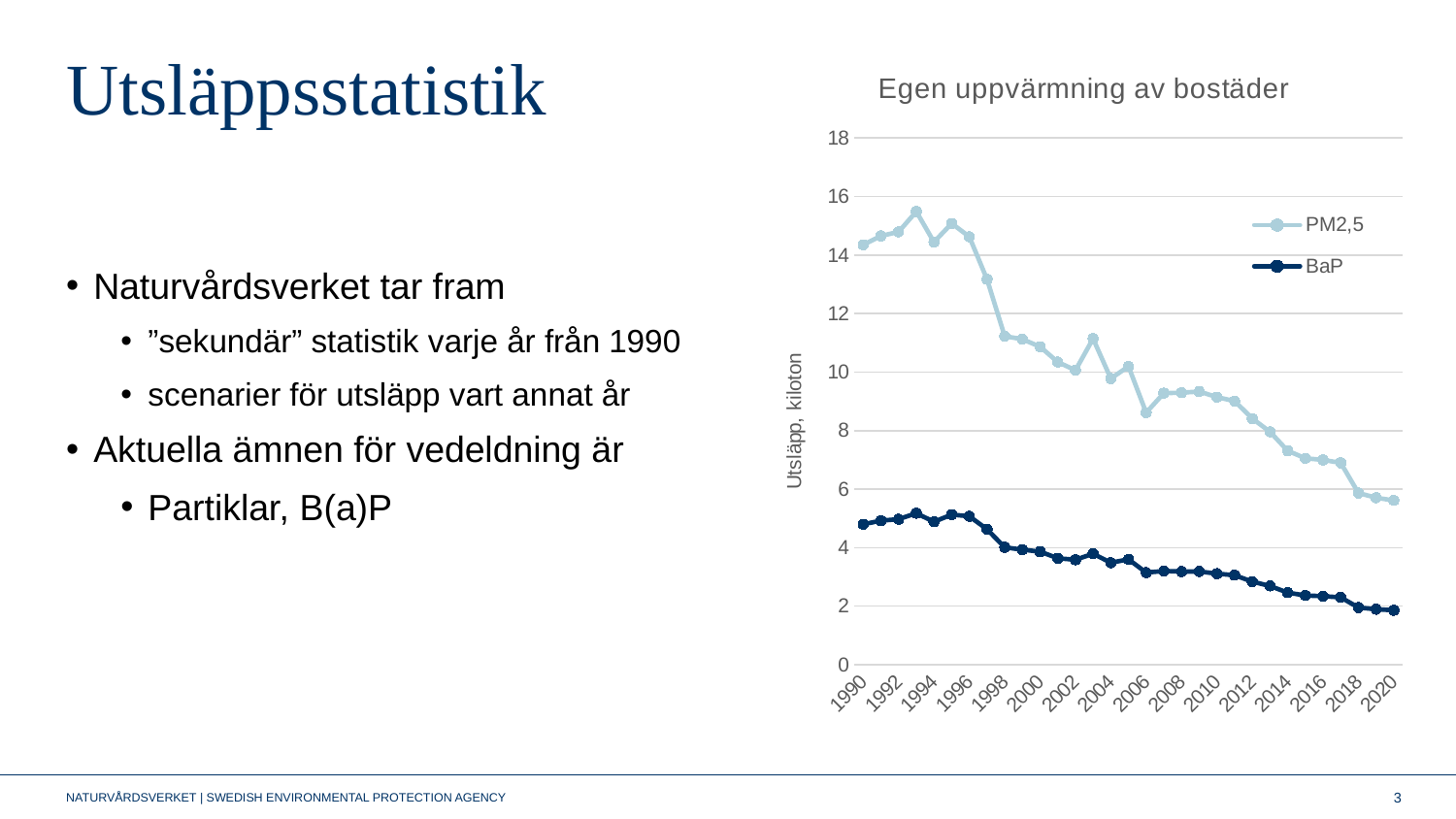
Is the value for BaP in 1990 greater or less than 4? greater Is the value for PM2,5 in 2010 greater or less than 8? greater Does the PM2,5 series generally rise or fall from 1990 to 2020? Fall Is the value for PM2,5 in 2020 greater or less than 6? less Does the BaP series generally rise or fall from 1990 to 2020? Fall How many series does the chart's legend list? 2 What is the label on the chart's vertical axis? Utsläpp, kiloton What kind of chart is shown on the slide? Line chart In 2000, which series has the larger value, PM2,5 or BaP? PM2,5 What is the title of the chart? Egen uppvärmning av bostäder